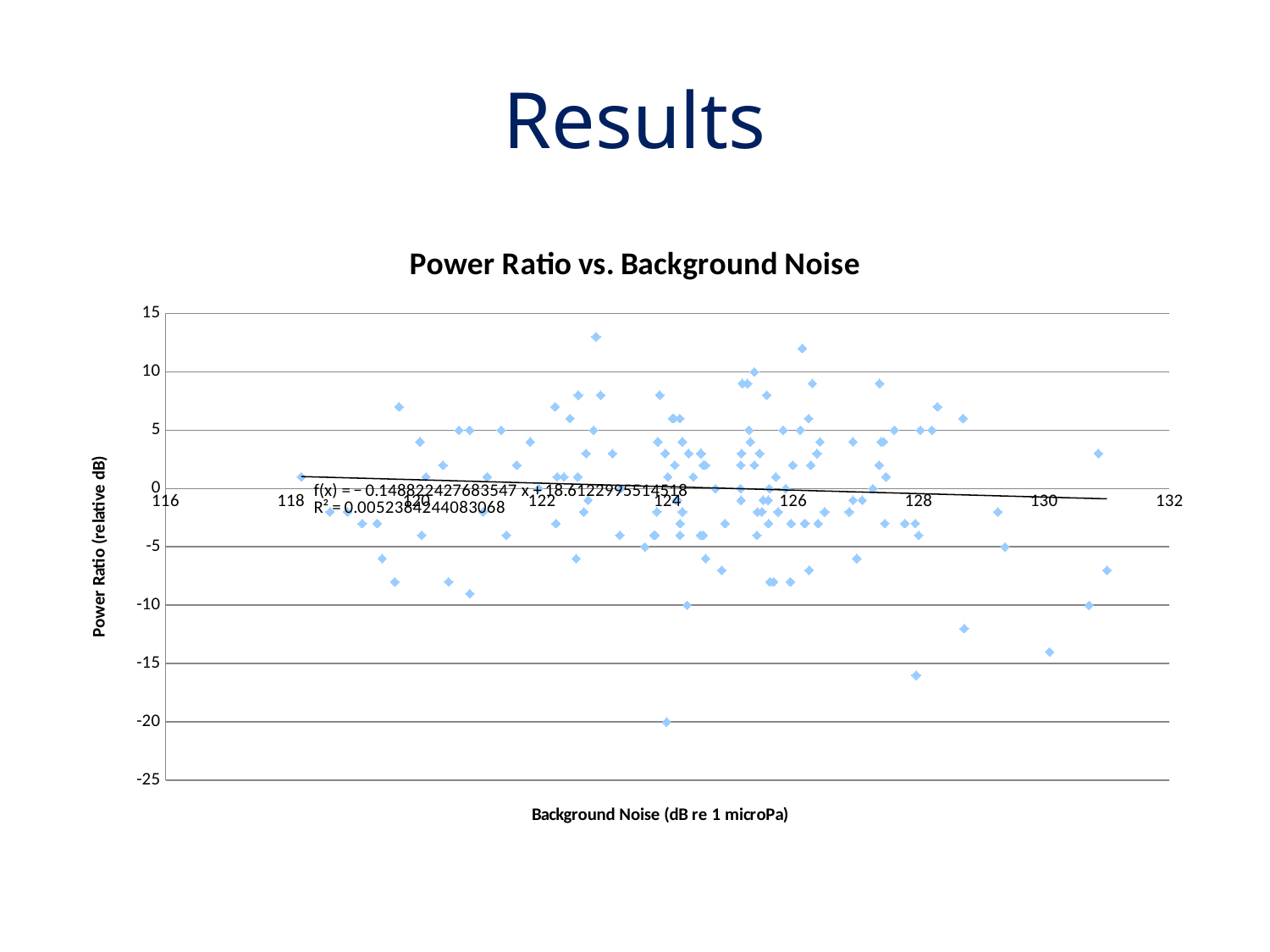
What is the title of the chart? Power Ratio vs. Background Noise What kind of chart is shown on the slide? scatter chart What is the maximum value shown on the horizontal axis? 132 What is the label of the vertical axis? Power Ratio (relative dB) Is the lowest plotted point located at a background noise greater or less than 126? less Is the slope of the fitted line f(x) positive or negative? negative Does the fitted trend line rise or fall as background noise increases along the x axis? falls Is the lowest plotted power ratio value greater or less than -15? less Is the highest plotted power ratio value greater or less than 10? greater